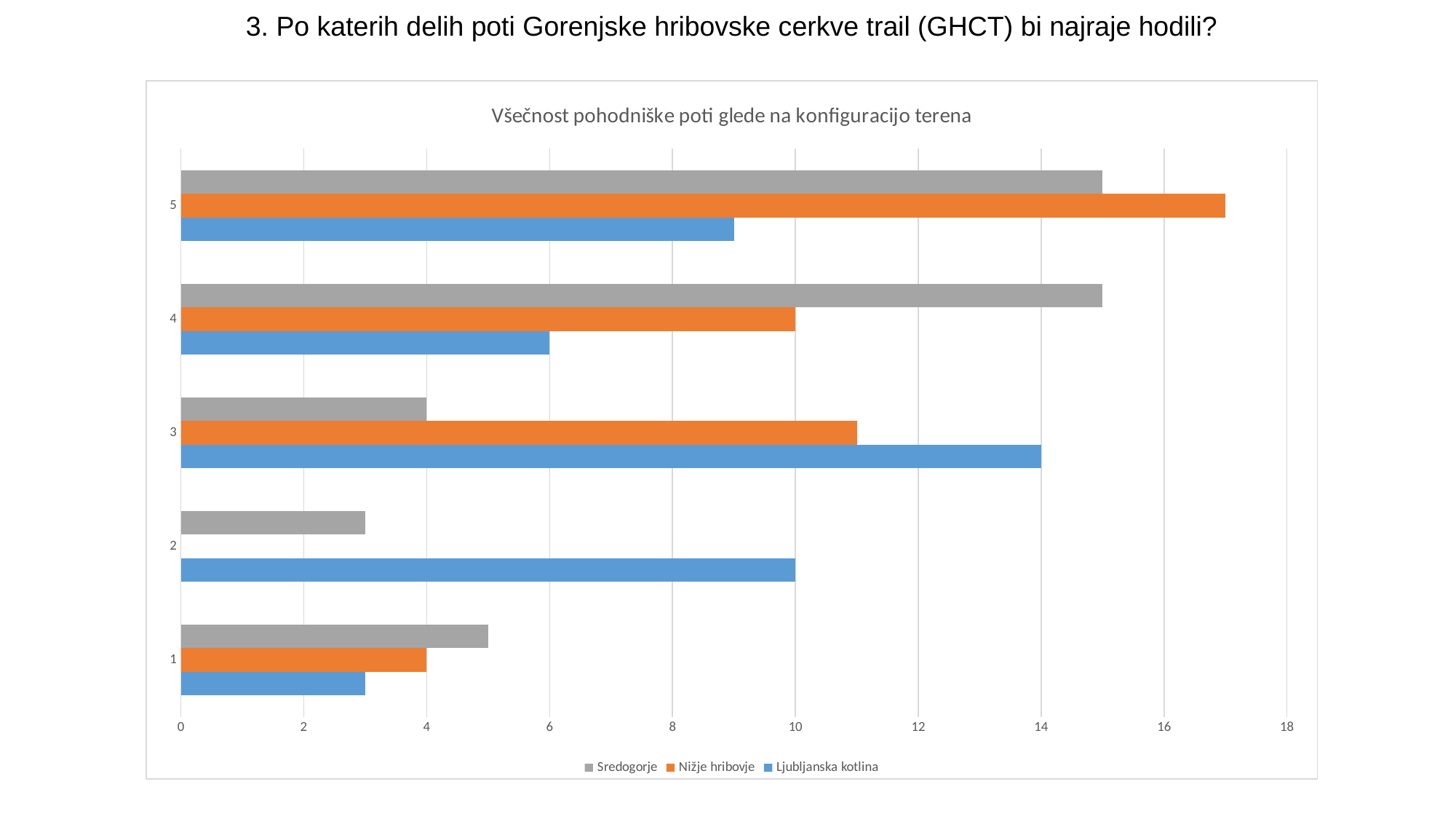
In which category is the Ljubljanska kotlina bar the shortest? 1 Is the value for Nižje hribovje in category 5 greater or less than 16? greater What kind of chart is shown on the slide? bar chart What is the value for Ljubljanska kotlina in category 3? 14 What is the difference between Ljubljanska kotlina and Sredogorje in category 3? 10 How many series does the legend list? 3 In category 3, which is larger: Ljubljanska kotlina or Nižje hribovje? Ljubljanska kotlina Is the value for Ljubljanska kotlina in category 5 greater or less than 10? less How many categories are shown on the vertical axis? 5 What is the value for Ljubljanska kotlina in category 2? 10 In which category is the Nižje hribovje bar the longest? 5 What is the value for Nižje hribovje in category 4? 10